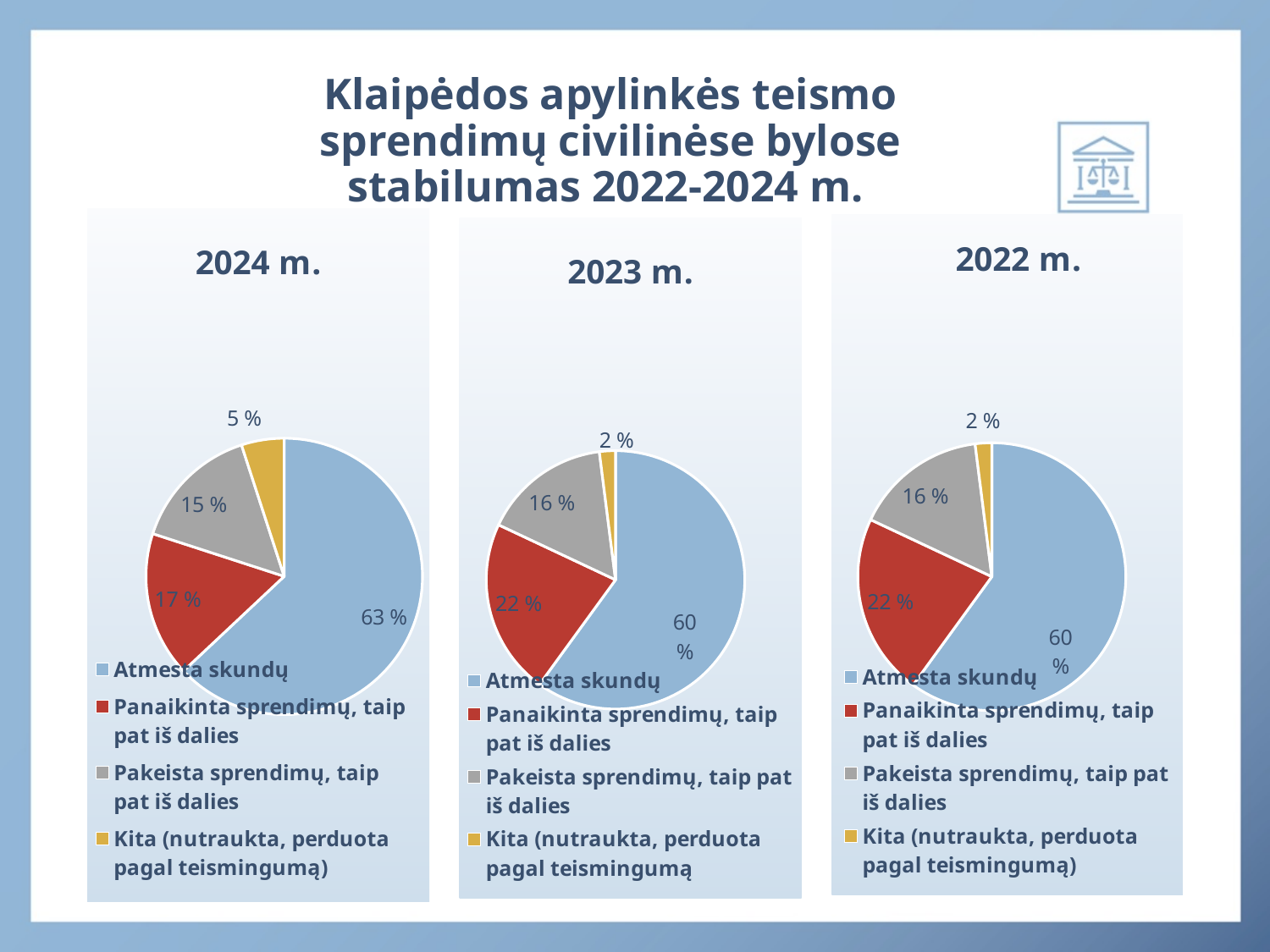
In the 2024 m. pie chart, what share is shown for Atmesta skundų? 63 % In the 2022 m. pie chart, what colour is the Atmesta skundų slice? Blue In the 2023 m. pie chart, which category has the smallest slice? Kita (nutraukta, perduota pagal teismingumą) In the 2024 m. pie chart, what share is shown for Panaikinta sprendimų, taip pat iš dalies? 17 % What is the difference between the Atmesta skundų share in the 2024 m. chart and in the 2023 m. chart? 3 % In the 2023 m. pie chart, what share is shown for Pakeista sprendimų, taip pat iš dalies? 16 % In the 2022 m. pie chart, what share is shown for Kita (nutraukta, perduota pagal teismingumą)? 2 % How many pie charts are shown on the slide? 3 What type of chart is used for 2023 m.? Pie chart In the 2024 m. pie chart, which category has the largest slice? Atmesta skundų How many slices does the 2024 m. pie chart have? 4 In the 2022 m. pie chart, which is larger: Panaikinta sprendimų, taip pat iš dalies or Pakeista sprendimų, taip pat iš dalies? Panaikinta sprendimų, taip pat iš dalies